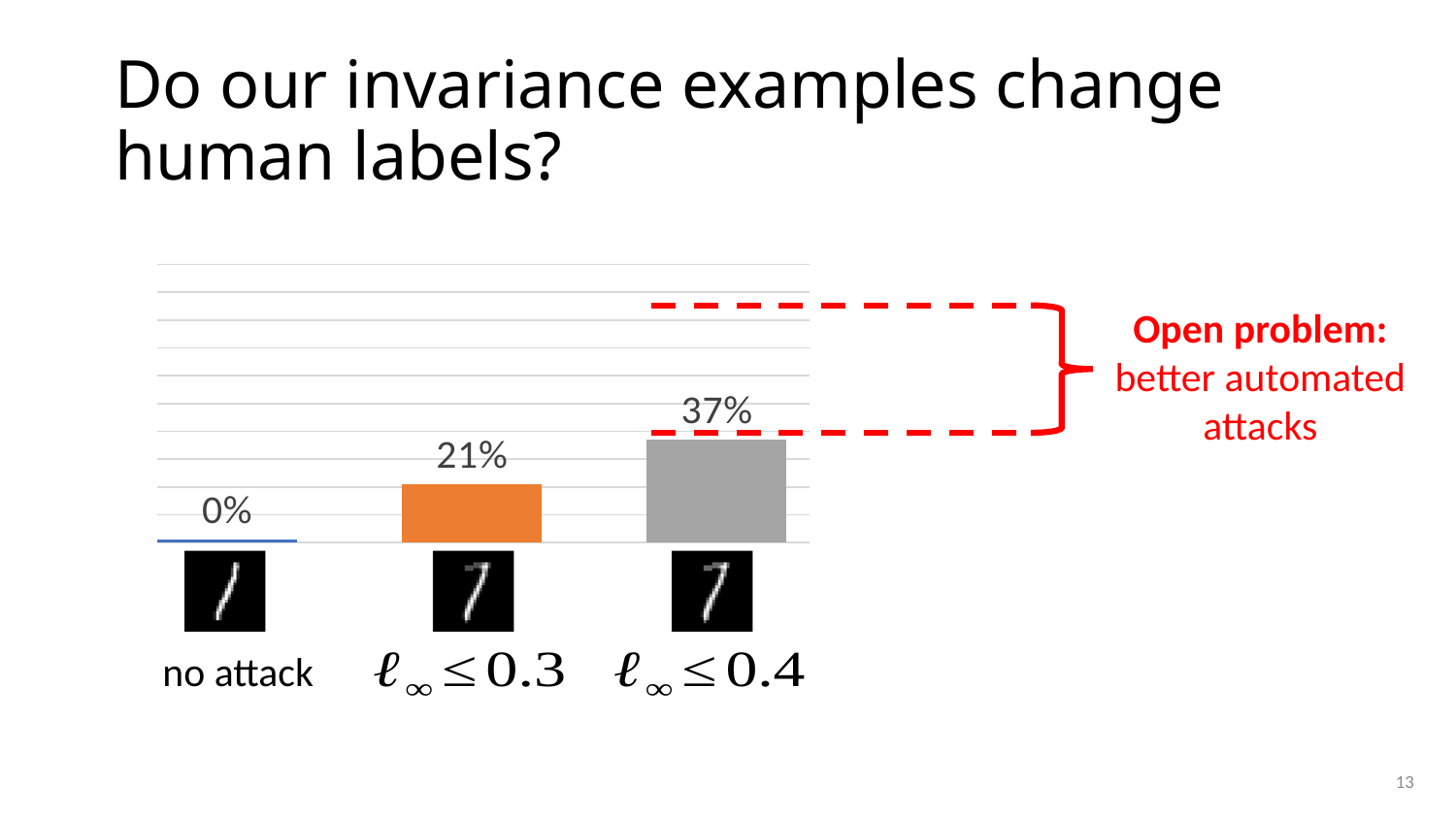
What is the difference between the values for ℓ∞ ≤ 0.4 and ℓ∞ ≤ 0.3? 16% Do the values rise or fall from left to right across the categories? rise Which is larger, the value for ℓ∞ ≤ 0.3 or the value for ℓ∞ ≤ 0.4? ℓ∞ ≤ 0.4 How many categories are shown in the chart? 3 What kind of chart is shown on the slide? bar chart What is the value for the ℓ∞ ≤ 0.3 category? 21% What is the value for the "no attack" category? 0% What is the value for the ℓ∞ ≤ 0.4 category? 37% Which category has the lowest value? no attack What colour is the bar for the ℓ∞ ≤ 0.3 category? orange What is the difference between the values for ℓ∞ ≤ 0.3 and no attack? 21% Which category has the highest value? ℓ∞ ≤ 0.4